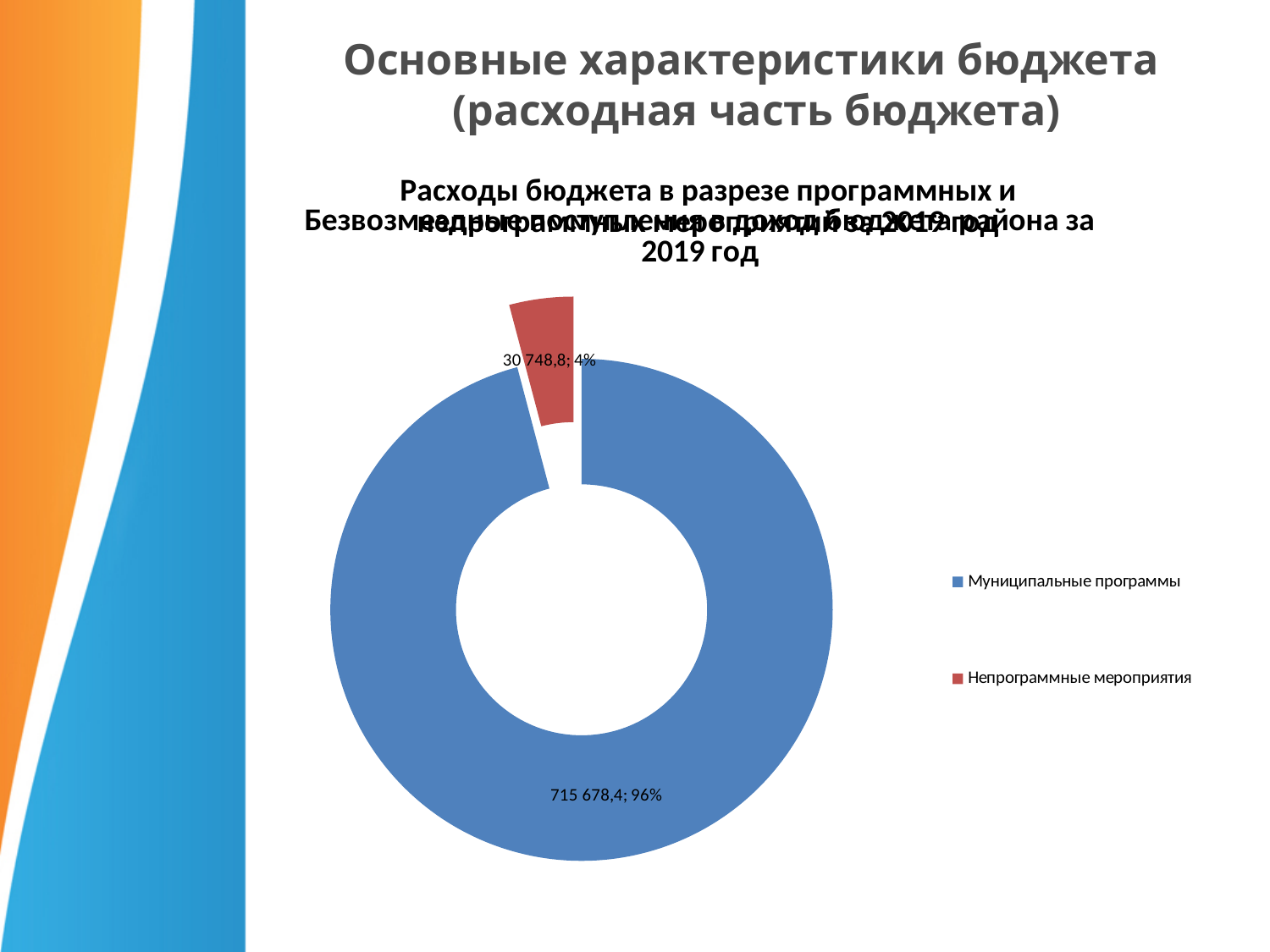
What percentage share does Муниципальные программы have? 96% What is the difference in percentage points between the shares of Муниципальные программы and Непрограммные мероприятия? 92 How many categories are shown in the chart? 2 What value is shown for Муниципальные программы? 715 678,4 How many entries does the legend list? 2 What kind of chart is shown on the slide? Doughnut (pie) chart What value is shown for Непрограммные мероприятия? 30 748,8 What percentage share does Непрограммные мероприятия have? 4% What colour is the slice for Непрограммные мероприятия? Red Which category has the smallest share of the chart? Непрограммные мероприятия Which is larger, Муниципальные программы or Непрограммные мероприятия? Муниципальные программы Which category has the largest share of the chart? Муниципальные программы